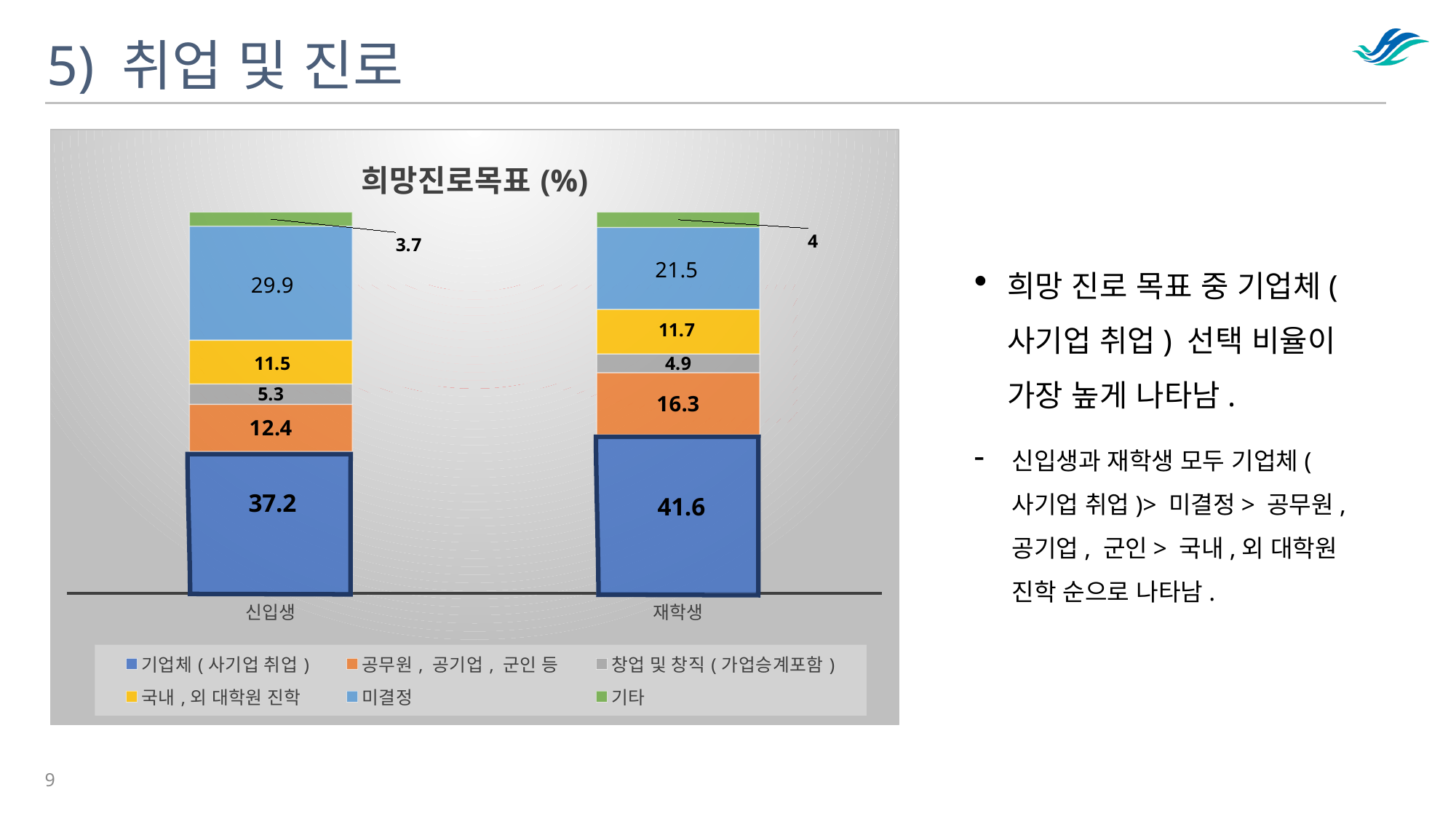
How many series does the legend list? 6 What is the value of 기업체 (사기업 취업) for 신입생? 37.2 What is the value of 미결정 for 재학생? 21.5 What is the difference between the 미결정 values for 신입생 and 재학생? 8.4 What is the total of the stacked bar for 신입생? 100 What is the value of 창업 및 창직 (가업승계포함) for 신입생? 5.3 Which category has the higher value for 기업체 (사기업 취업), 신입생 or 재학생? 재학생 What is the title of the chart? 희망진로목표 (%) What type of chart is shown on the slide? stacked bar chart How many categories are shown on the x axis? 2 What is the value of 기타 for 재학생? 4 Which series has the largest value within the 재학생 bar? 기업체 (사기업 취업)